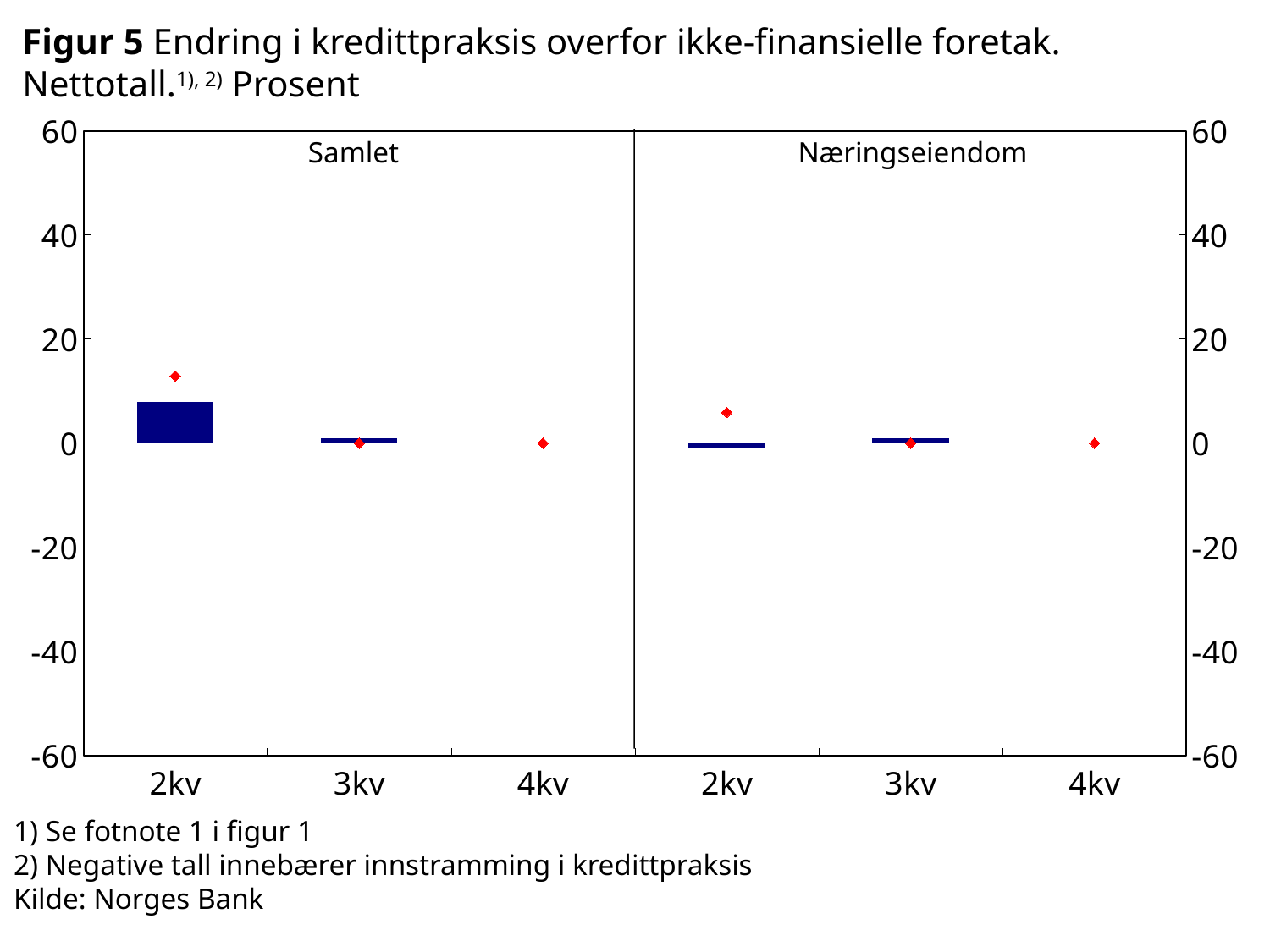
What kind of chart is shown on the slide? combination bar and line chart (bars with red diamond markers) In the Samlet panel, which quarter has the highest bar? 2kv Which bar is larger: 2kv or 3kv in the Samlet panel? 2kv Is the bar for 2kv in the Næringseiendom panel greater or less than 0? less Do the bars in the Samlet panel rise or fall from 2kv to 4kv? fall Is the bar for 2kv in the Samlet panel greater or less than 20? less What is the maximum value shown on the vertical axis? 60 What are the two panel labels shown inside the chart? Samlet and Næringseiendom What is the title of the chart? Figur 5 Endring i kredittpraksis overfor ikke-finansielle foretak. Nettotall. Prosent Is the bar for 2kv in the Samlet panel greater or less than 0? greater How many quarter categories are shown along the x axis in total across both panels? 6